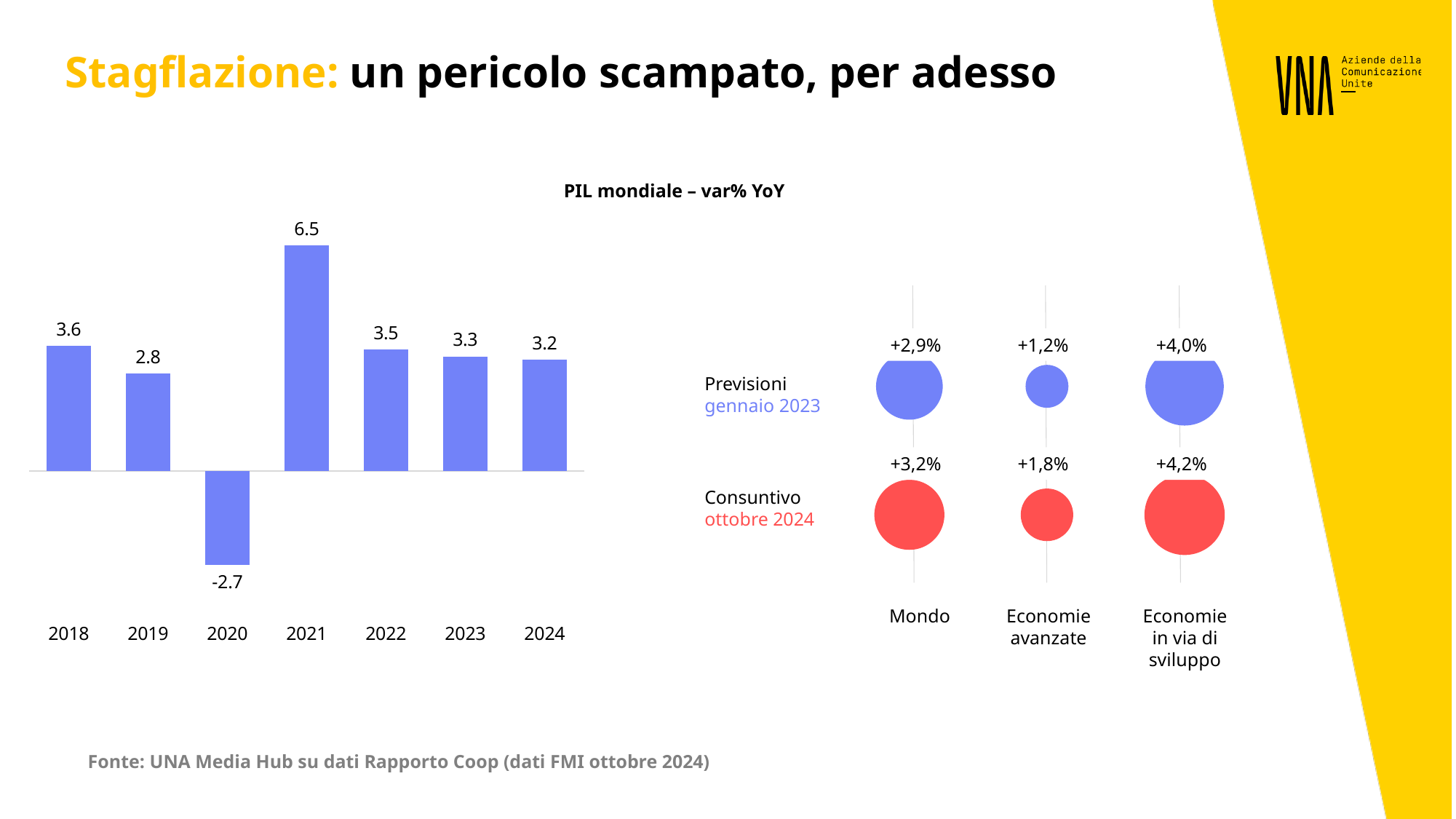
In the bar chart 'PIL mondiale – var% YoY', which year has the highest value? 2021 In the bubble chart on the right, what is the 'Previsioni gennaio 2023' value for Economie avanzate? +1,2% In the bar chart 'PIL mondiale – var% YoY', what is the difference between the values for 2021 and 2022? 3.0 In the bar chart 'PIL mondiale – var% YoY', what is the value for 2021? 6.5 In the bubble chart on the right, what is the 'Consuntivo ottobre 2024' value for Mondo? +3,2% In the bar chart 'PIL mondiale – var% YoY', which is larger, the value for 2018 or the value for 2019? 2018 In the bar chart 'PIL mondiale – var% YoY', do the values rise or fall from 2022 to 2024? fall In the bubble chart on the right, which category has the highest 'Consuntivo ottobre 2024' value? Economie in via di sviluppo In the bar chart 'PIL mondiale – var% YoY', what is the value for 2020? -2.7 In the bar chart 'PIL mondiale – var% YoY', which year has the lowest value? 2020 What kind of chart is 'PIL mondiale – var% YoY'? bar chart How many years are shown in the bar chart 'PIL mondiale – var% YoY'? 7